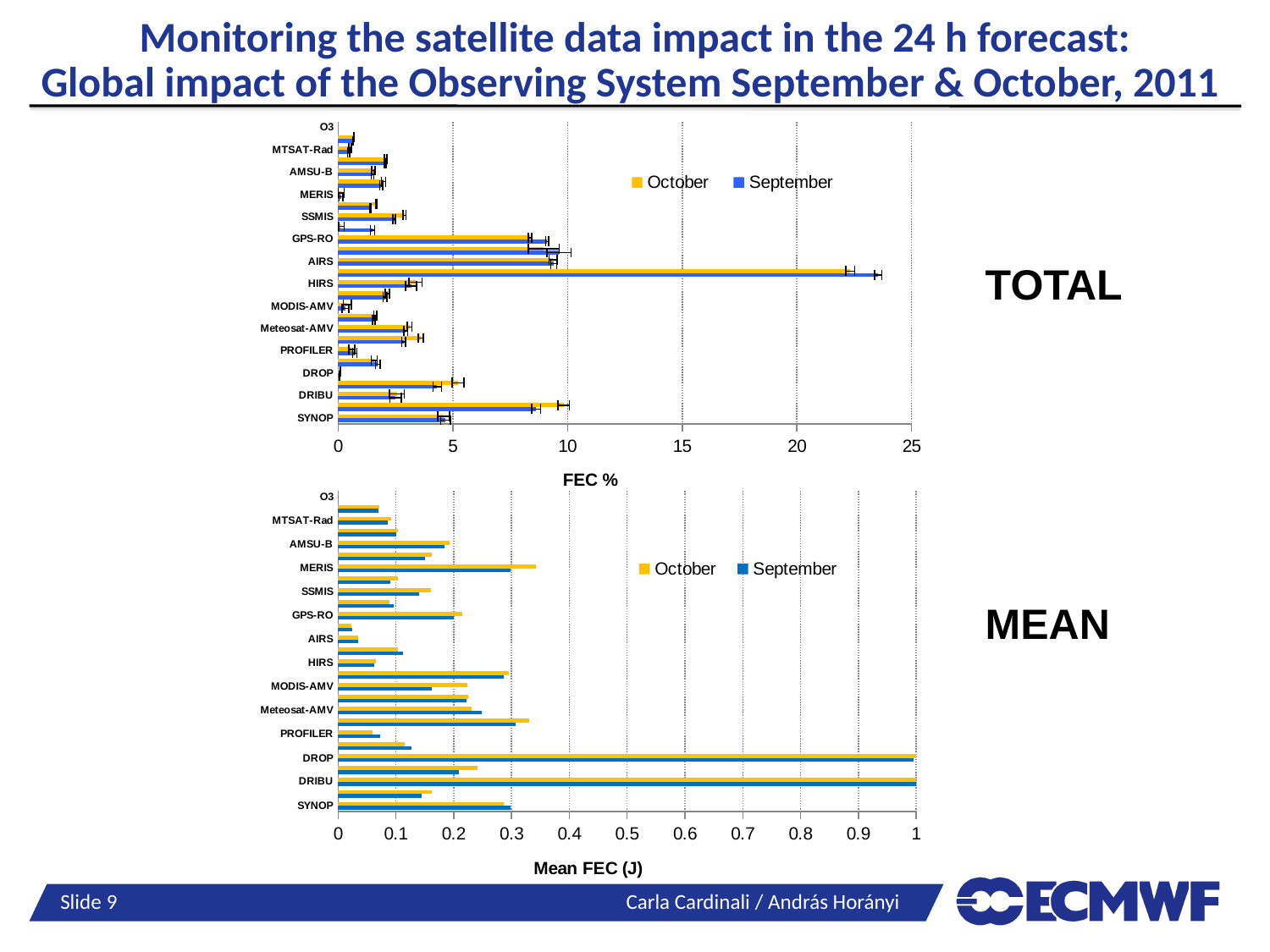
In the MEAN chart, is the October value for DROP greater or less than 0.9? greater In the MEAN chart, is the October value for GPS-RO greater or less than 0.3? less In the TOTAL chart, is the October value for HIRS greater or less than 5? less How many series does the legend of the TOTAL chart list? 2 How many categories are shown on the y axis of the MEAN chart? 14 What is the x-axis title of the MEAN chart? Mean FEC (J) In the TOTAL chart, which is larger, the October value for AIRS or the October value for SYNOP? AIRS